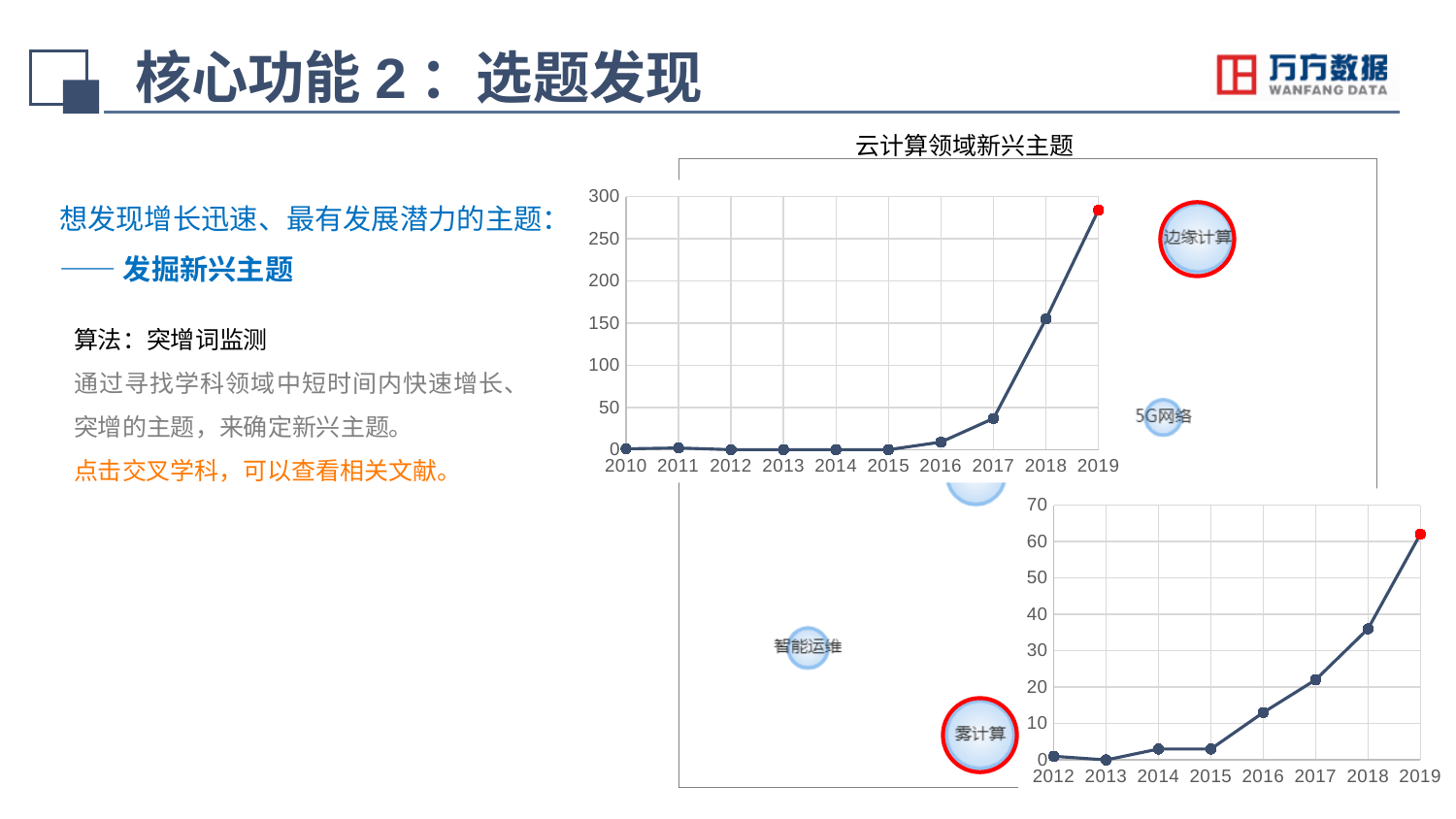
In the lower right line chart (2012–2019), which year has the highest value? 2019 What is the title of the bubble chart on the slide? 云计算领域新兴主题 In the upper line chart (2010–2019), do the values rise or fall from 2016 to 2019? rise In the lower right line chart (2012–2019), is the value for 2018 greater or less than 40? less In the upper line chart (2010–2019), which year has the highest value? 2019 How many years are plotted on the x axis of the lower right line chart? 8 What kind of chart is the upper chart with years 2010 to 2019 on the x axis? line chart In the upper line chart (2010–2019), is the value for 2018 greater or less than 100? greater In the upper line chart (2010–2019), is the value for 2017 greater or less than 50? less How many years are plotted on the x axis of the upper line chart? 10